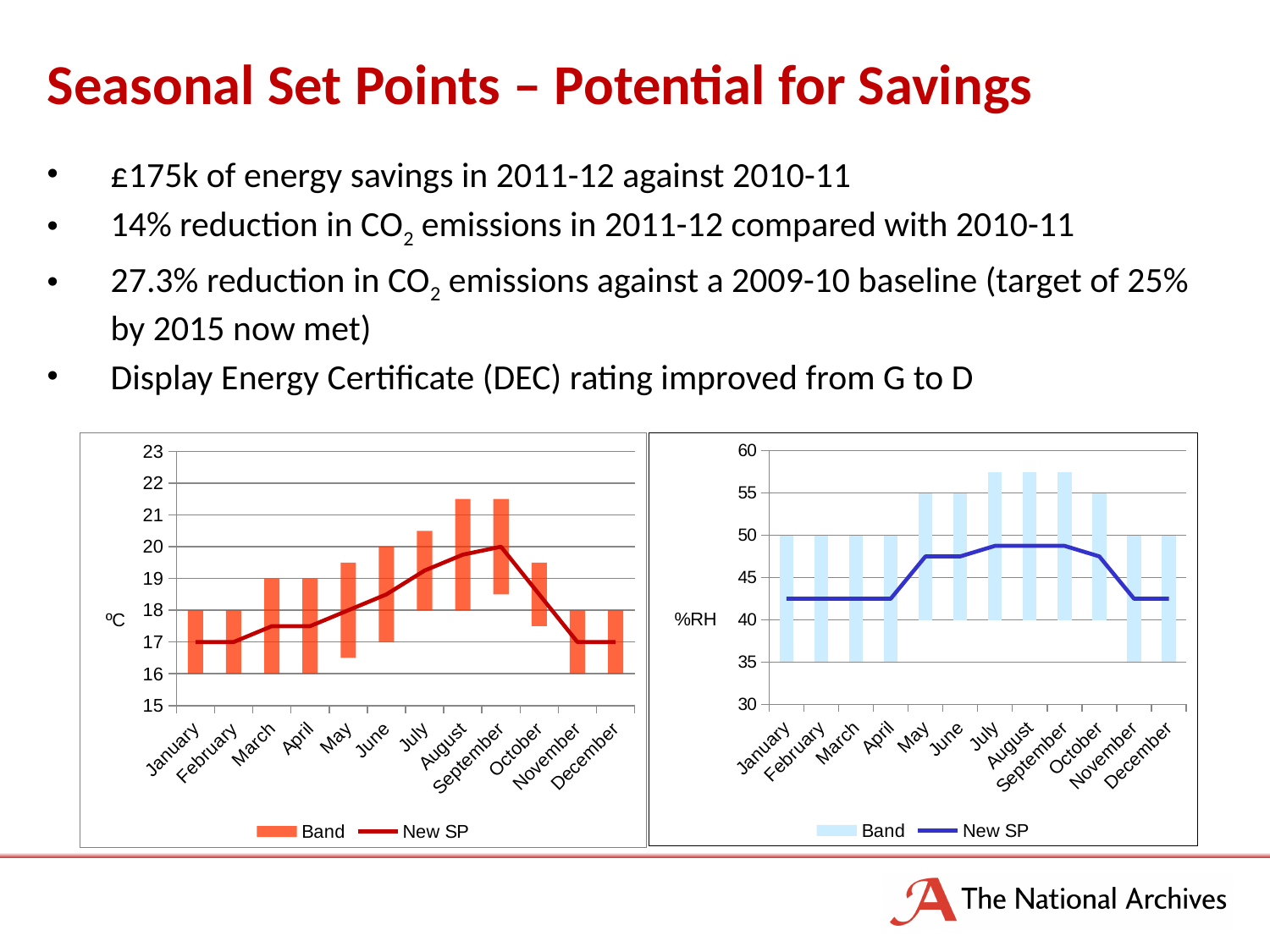
On the right chart (%RH), does the New SP line rise or fall from September to November? fall On the right chart (%RH), is the New SP value for July greater or less than 45? greater On the left chart (°C), does the New SP line rise or fall from January to September? rise What are the two series named in the legend of the right chart (%RH)? Band and New SP On the left chart (°C), which is larger, the New SP value for September or for January? September On the left chart (°C), is the New SP value for August greater or less than 19? greater How many series does the legend of the left chart (°C) list? 2 How many months are shown on the x axis of the right chart (%RH)? 12 On the right chart (%RH), is the New SP value for January greater or less than 45? less On the left chart (°C), what is the New SP value for January? 17 On the left chart (°C), in which month does the New SP line reach its highest value? September On the left chart (°C), what is the New SP value for September? 20